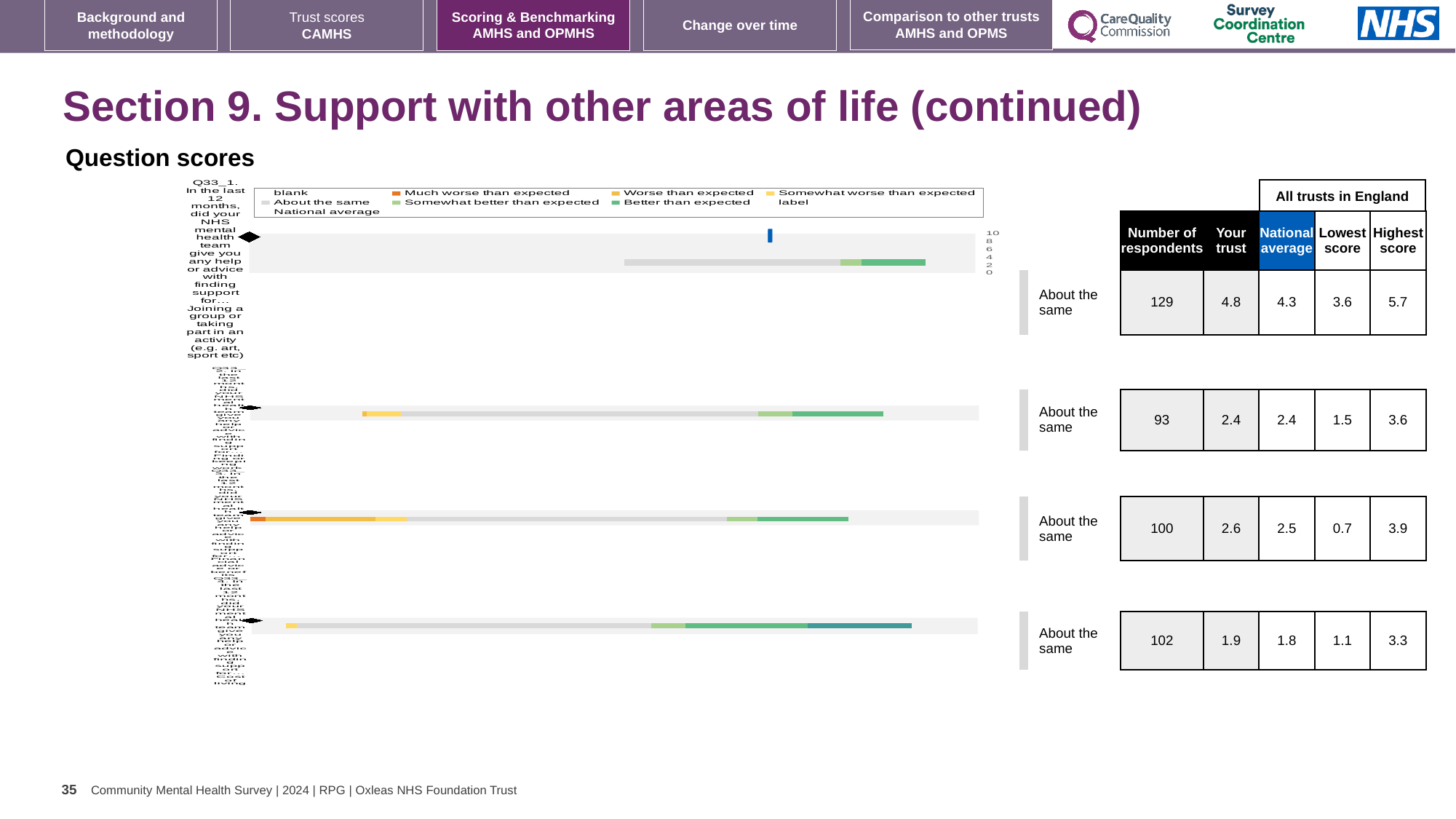
In the question scores chart legend, what colour is 'Better than expected'? green For Q33_1, which is larger: the 'Your trust' score or the national average? Your trust Which question row has the highest number of respondents? Q33_1 (the top row), with 129 What is the lowest 'Lowest score' value shown in the table for any of the four questions? 0.7 What is the benchmark category shown for the bottom question row? About the same For Q33_1 (help finding support for joining a group or taking part in an activity), what is the number of respondents? 129 For Q33_1 (help finding support for joining a group or taking part in an activity), what is the 'Your trust' score? 4.8 What kind of chart is used to show the question scores on this slide? bar chart For Q33_1, what is the difference between the highest score and the lowest score across all trusts in England? 2.1 In the question scores chart legend, which entry is shown in orange? Much worse than expected For Q33_1 (help finding support for joining a group or taking part in an activity), what is the national average score? 4.3 How many question bars are plotted in the question scores chart? 4